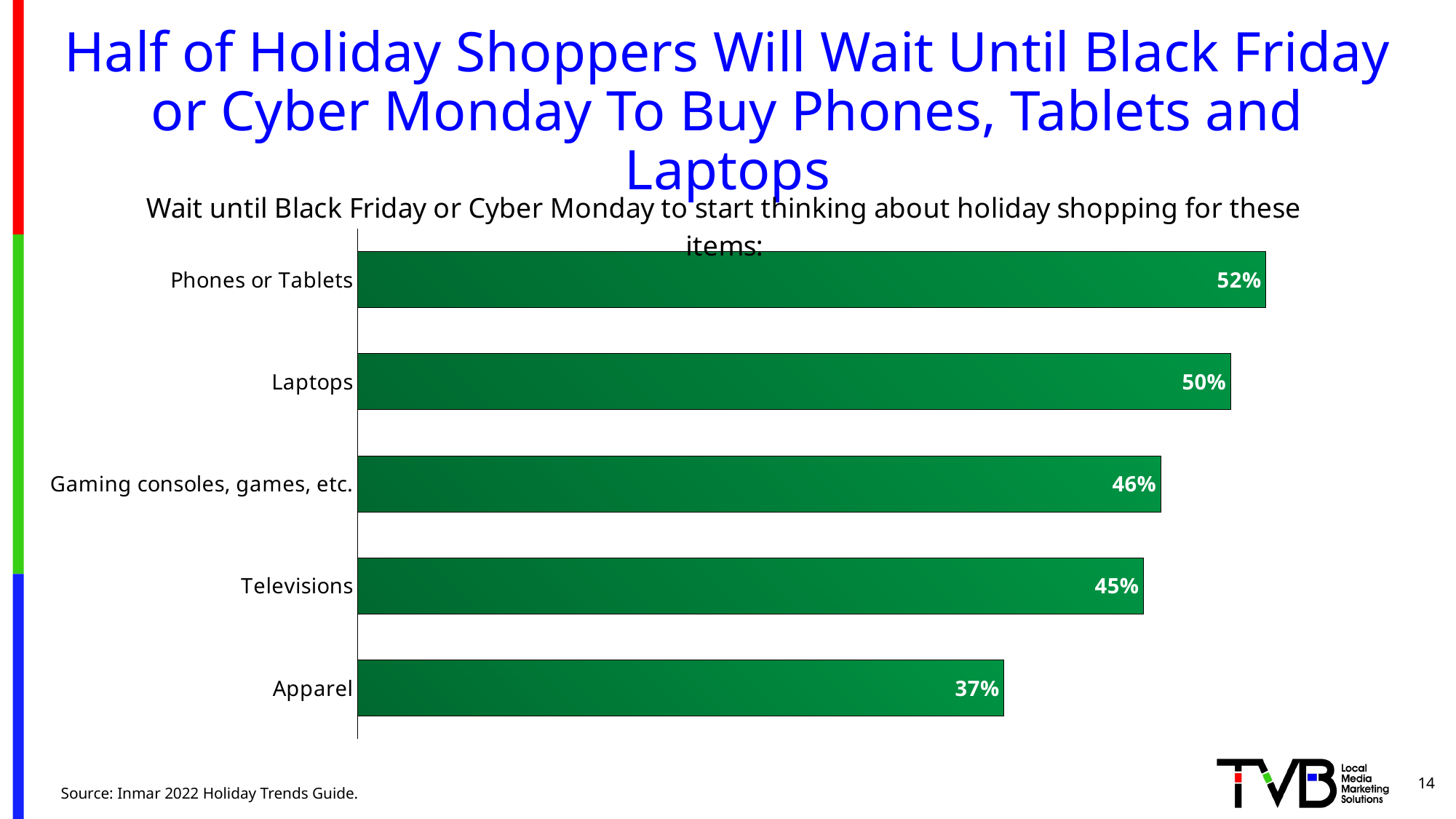
What colour are the bars in the chart? Green What is the difference between the values for Phones or Tablets and Apparel? 15% What percentage of shoppers wait until Black Friday or Cyber Monday to start thinking about holiday shopping for Phones or Tablets? 52% Which category has the highest value? Phones or Tablets What is the value shown for Televisions? 45% What is the difference between the values for Gaming consoles, games, etc. and Televisions? 1% How many categories are shown in the chart? 5 Which category has the lowest value? Apparel What is the value shown for Apparel? 37% What kind of chart is shown on the slide? Bar chart What is the value shown for Laptops? 50% Which is larger, the value for Laptops or the value for Televisions? Laptops